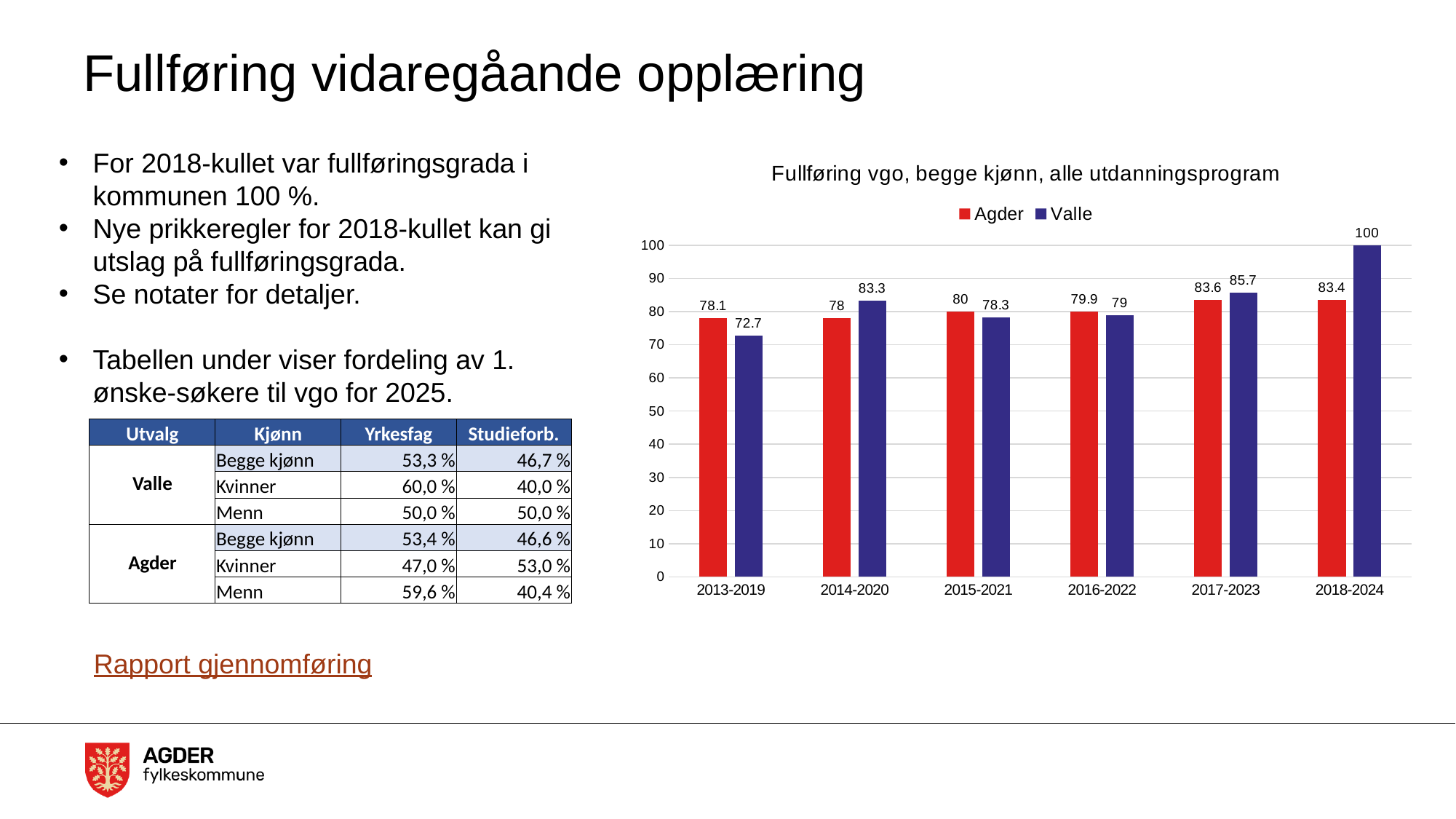
How many series does the legend list? 2 What kind of chart is shown? Bar chart In which period is the Valle value highest? 2018-2024 How many periods are shown on the x axis? 6 What is the value for Valle in 2014-2020? 83.3 What is the value for Valle in 2018-2024? 100 In which period is the Valle value lowest? 2013-2019 What is the value for Agder in 2017-2023? 83.6 What is the title of the chart? Fullføring vgo, begge kjønn, alle utdanningsprogram What is the difference between the Valle and Agder values in 2018-2024? 16.6 Which is larger in 2013-2019, Agder or Valle? Agder What is the value for Agder in 2013-2019? 78.1